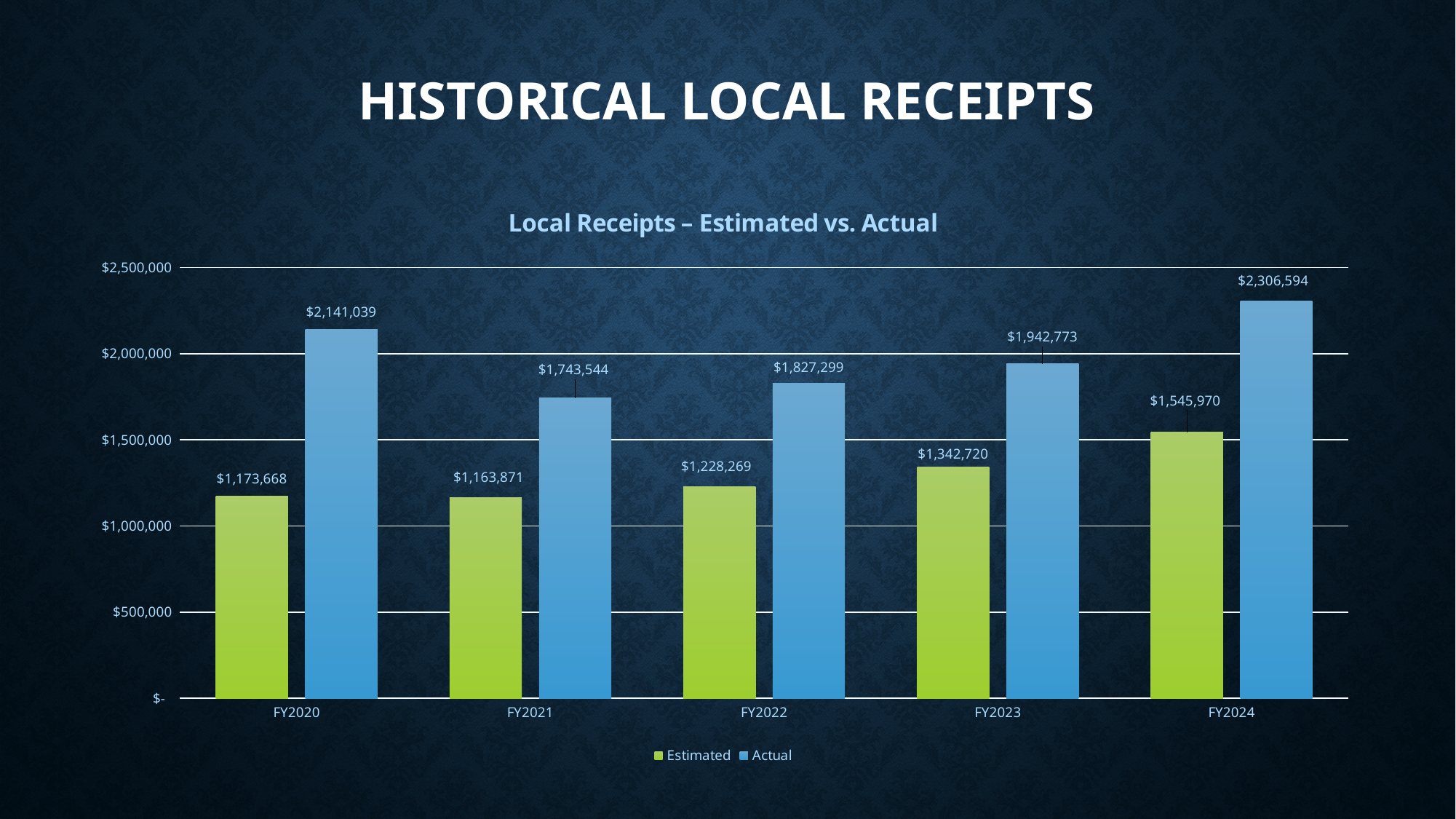
What kind of chart is shown on the slide? bar chart How many series does the legend list? 2 What is the Estimated value for FY2023? $1,342,720 How many fiscal years are shown on the x axis? 5 Is the Estimated value for FY2024 greater or less than $1,500,000? greater What is the Actual value for FY2022? $1,827,299 Which is larger, the Actual value for FY2021 or the Actual value for FY2023? FY2023 Do the Estimated values rise or fall from FY2021 to FY2024? rise What is the difference between the Actual and Estimated values for FY2020? $967,371 Which fiscal year has the lowest Estimated value? FY2021 Which fiscal year has the highest Actual value? FY2024 What is the difference between the Actual and Estimated values for FY2024? $760,624